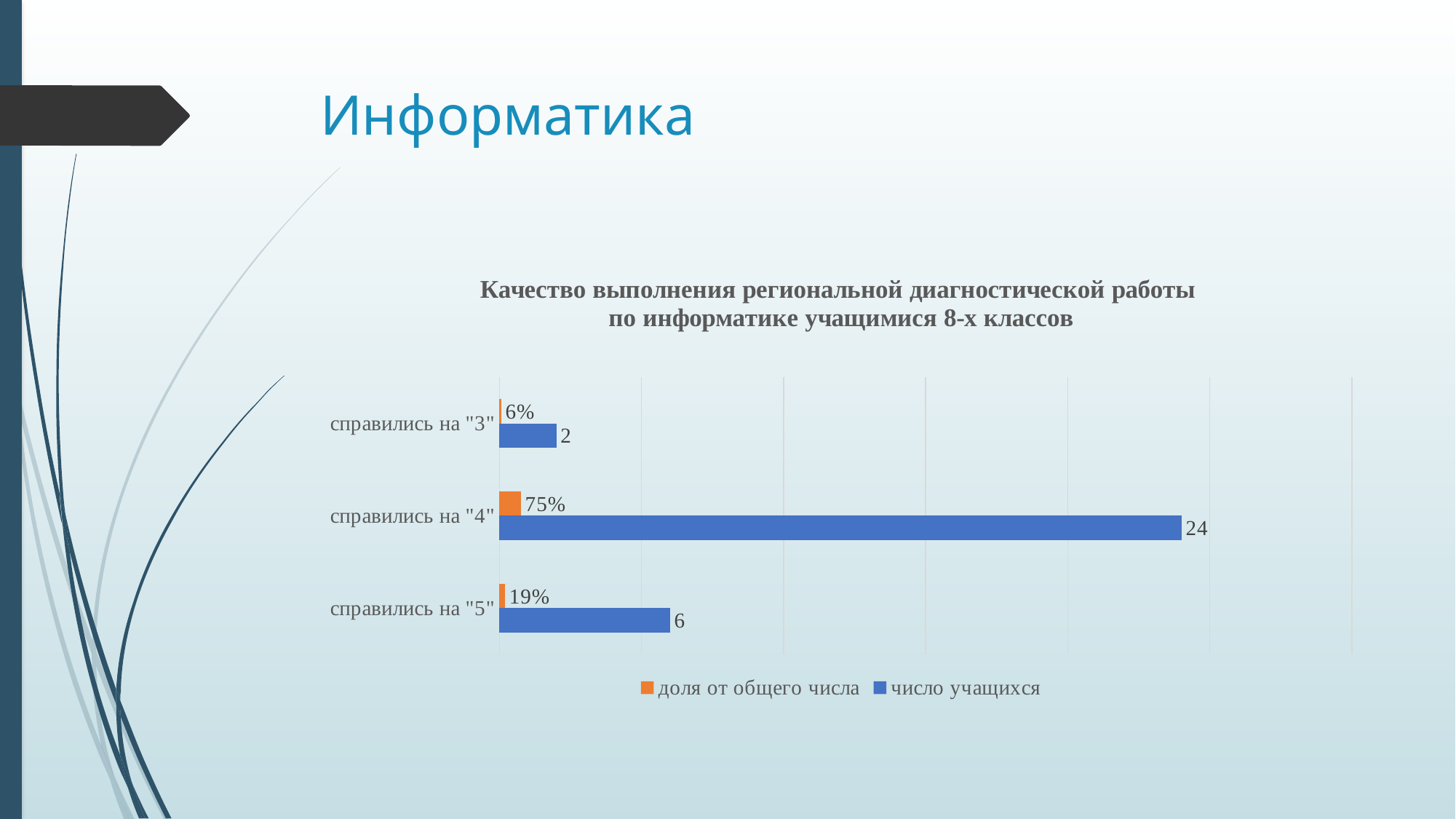
What share of the total (доля от общего числа) is shown for справились на "3"? 6% What is the difference in the number of students between справились на "4" and справились на "5"? 18 What is the number of students (число учащихся) who completed the work at grade "4" (справились на "4")? 24 What is the number of students (число учащихся) for справились на "3"? 2 Which category has the lowest share of the total (доля от общего числа)? справились на "3" How many categories are shown on the chart? 3 What kind of chart is shown on the slide? bar chart What share of the total (доля от общего числа) completed the work at grade "5" (справились на "5")? 19% How many series does the legend list? 2 Which is larger: the number of students for справились на "5" or for справились на "3"? справились на "5" Which category has the highest number of students (число учащихся)? справились на "4" Which colour represents the series число учащихся in the legend? blue